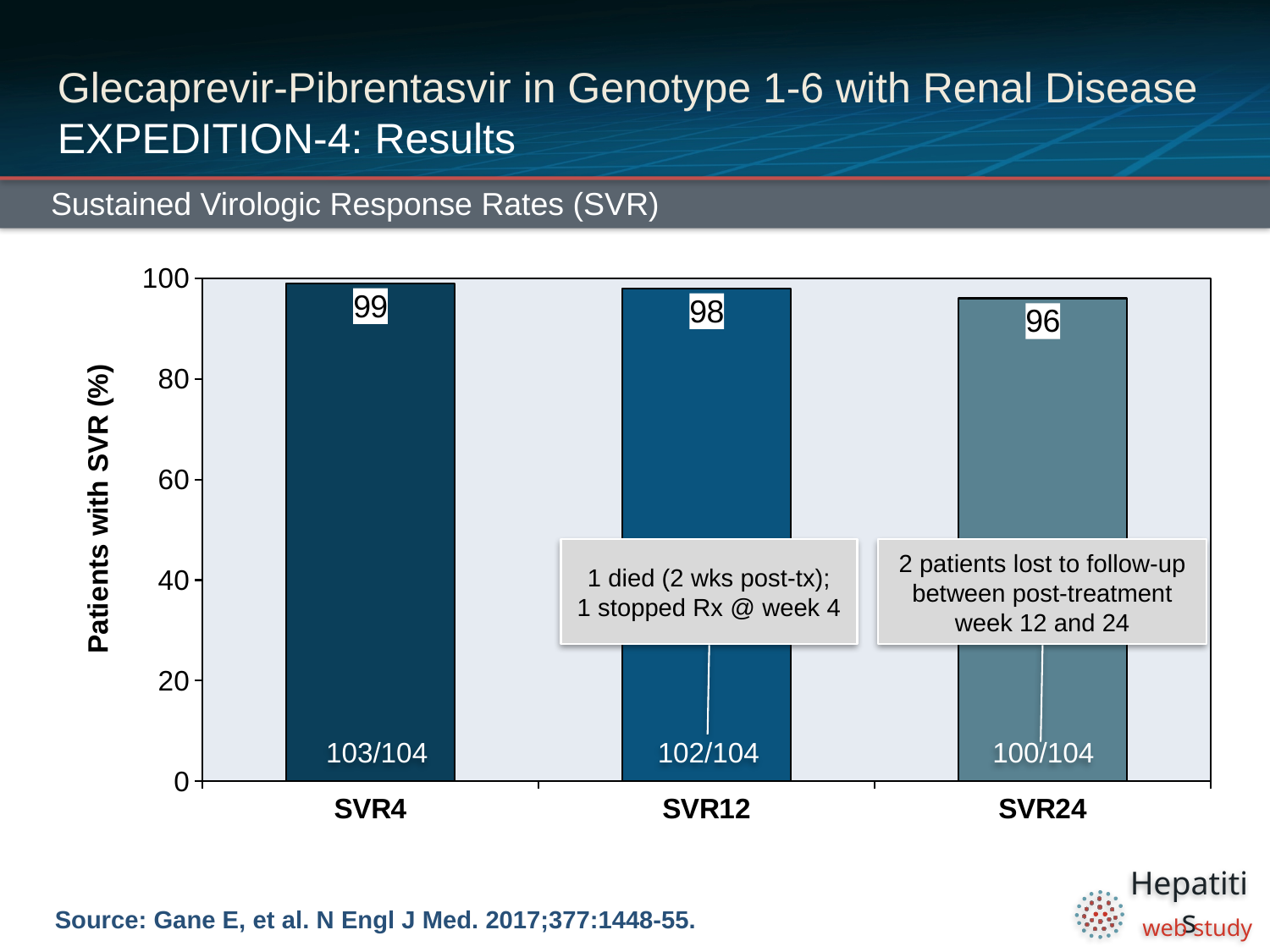
Which is larger, the value for SVR12 or the value for SVR24? SVR12 What is the value for SVR24? 96 What is the value for SVR4? 99 What kind of chart is shown? bar chart What fraction of patients is printed on the SVR12 bar? 102/104 Which category has the lowest value? SVR24 Do the values rise or fall from SVR4 to SVR24? fall What is the difference between the values for SVR4 and SVR24? 3 Is the value for SVR24 greater or less than 80? greater Which category has the highest value? SVR4 How many categories are shown on the x axis? 3 What is the value for SVR12? 98